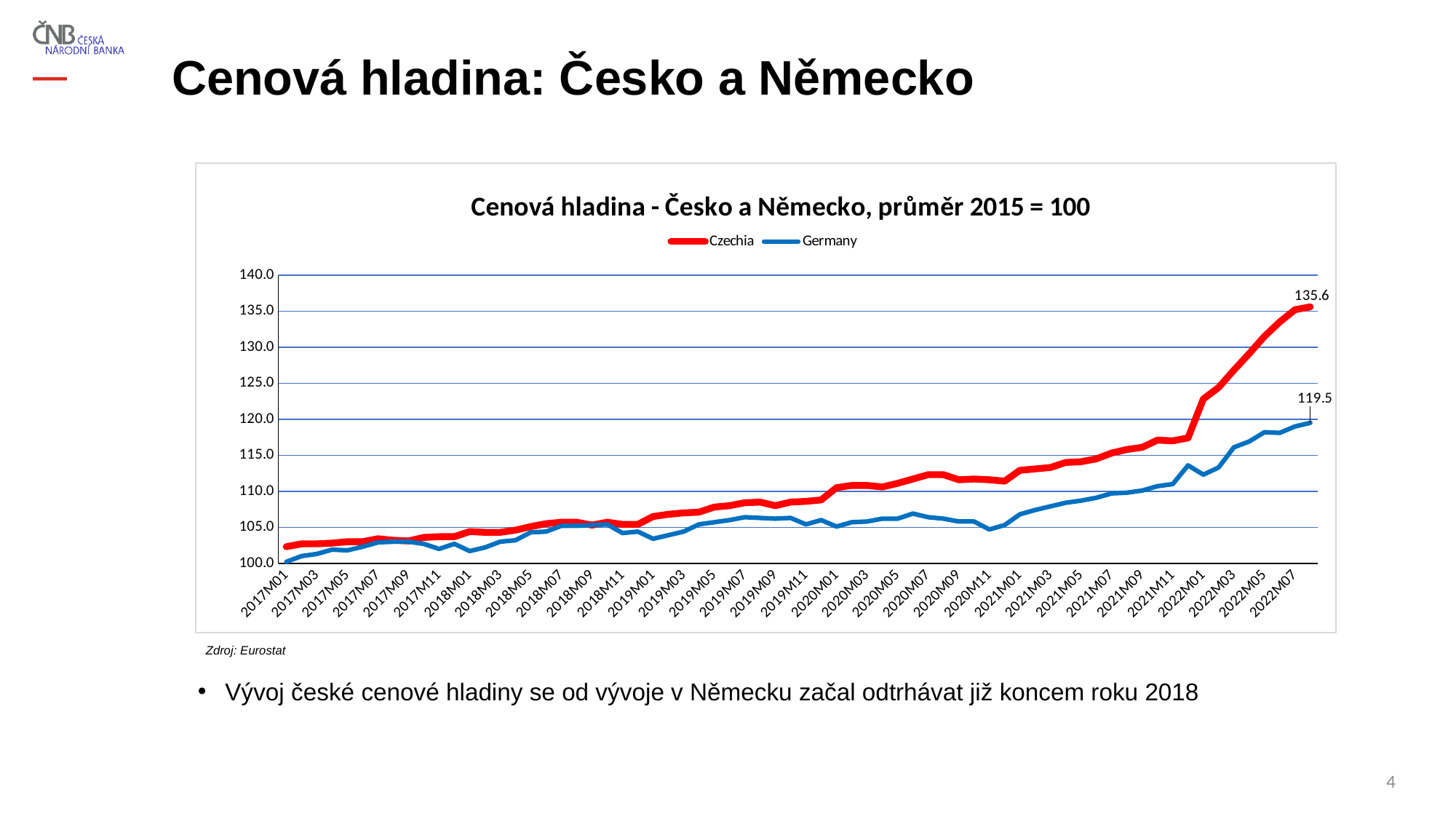
What type of chart is shown on the slide? line chart What is the difference between the final labelled values for Czechia (135.6) and Germany (119.5)? 16.1 Which colour is used for the Germany series in the chart? blue Do the values for Czechia generally rise or fall from 2017M01 to the end of the series? rise At the end of the series, which country has the higher price level, Czechia or Germany? Czechia What is the title of the chart? Cenová hladina - Česko a Německo, průměr 2015 = 100 Is the value for Germany in 2019M01 greater or less than 105.0? less Is the value for Germany in 2017M01 greater or less than 105.0? less Is the value for Czechia in 2022M07 greater or less than 130.0? greater What is the last labelled value for Germany on the chart? 119.5 What is the last labelled value for Czechia on the chart? 135.6 How many series does the chart legend list? 2